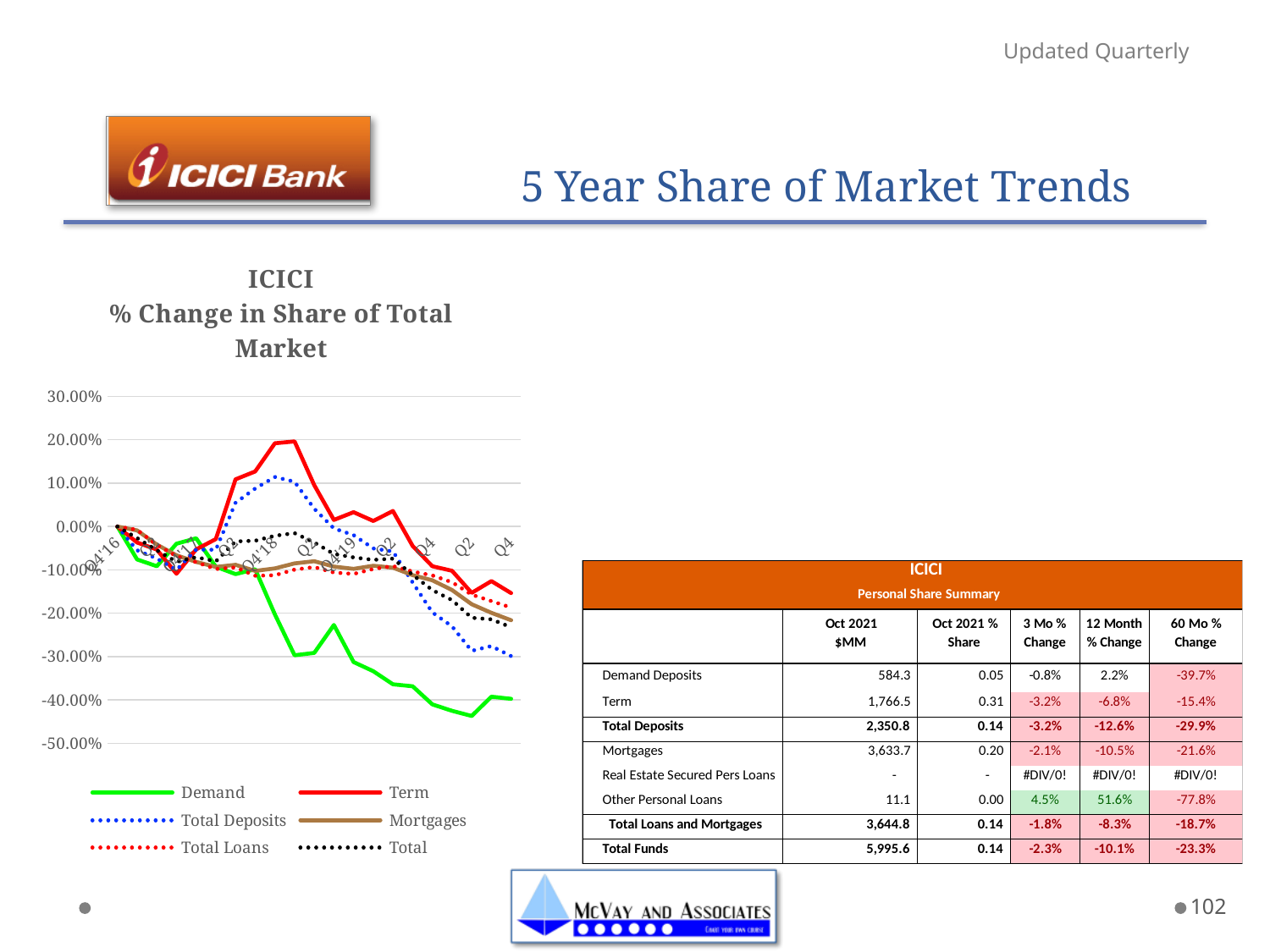
What kind of chart is shown on the slide? line chart Is the final value of the Total Deposits series greater or less than -20.00%? less Which series is drawn as the solid green line? Demand Does the Demand series overall rise or fall from left to right across the chart? fall Which series is the lowest at the right-hand end of the chart? Demand Is the peak value of the Term series greater or less than 10.00%? greater At the right-hand end of the chart, which is higher: Term or Demand? Term How many series does the chart's legend list? 6 Is the final value of the Term series greater or less than -20.00%? greater Which series reaches the highest peak on the chart? Term What is the title of the chart? ICICI % Change in Share of Total Market